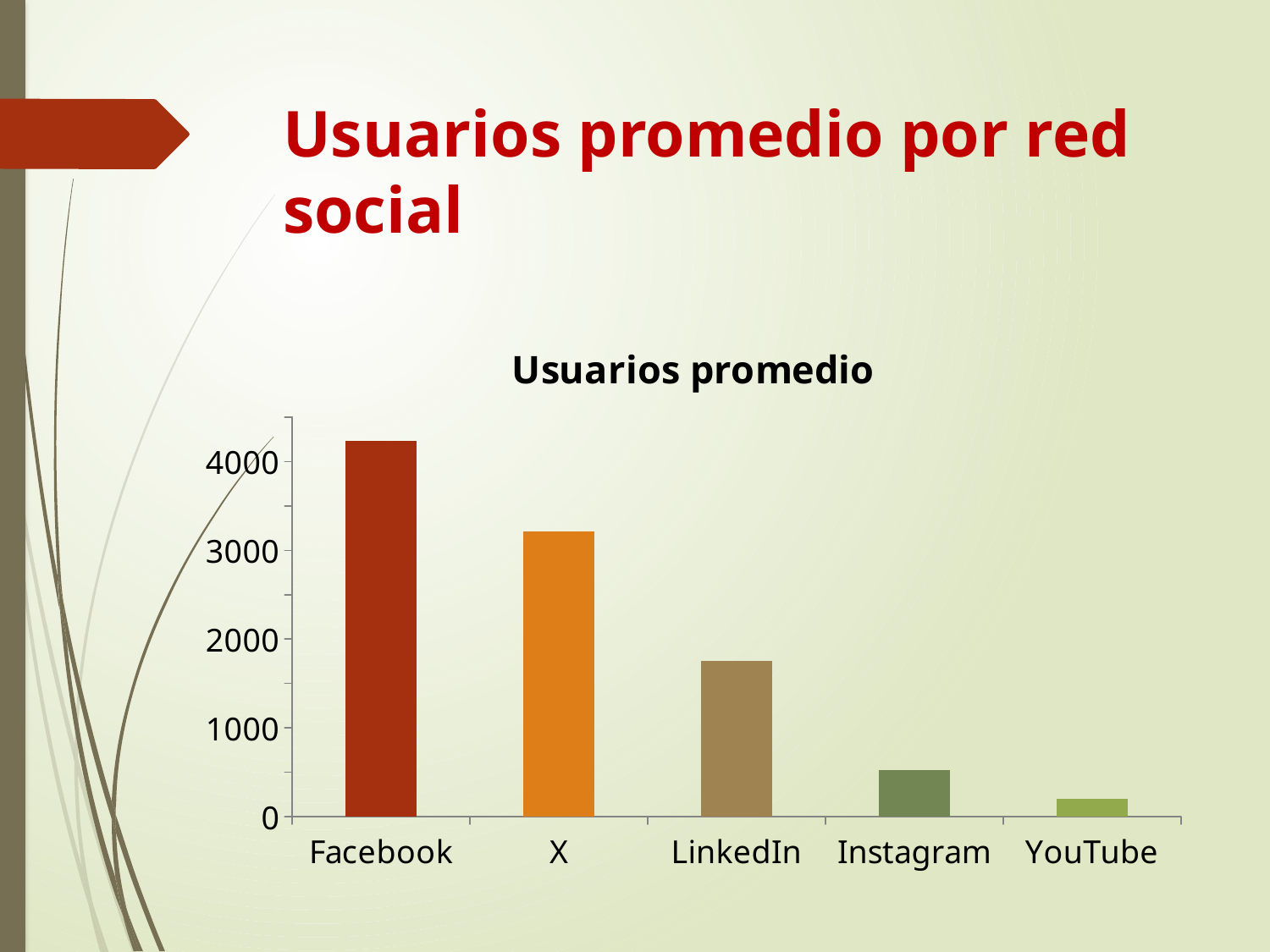
Which has more average users, X or LinkedIn? X Which social network has the lowest average number of users? YouTube What is the title of the chart? Usuarios promedio Do the values rise or fall from left to right along the x axis? fall Which social network has the highest average number of users? Facebook Is the value for Facebook greater or less than 4000? greater How many social networks are shown on the x axis of the chart? 5 Which has more average users, Instagram or YouTube? Instagram Is the value for LinkedIn greater or less than 2000? less Is the value for X greater or less than 3000? greater What kind of chart is shown on the slide? bar chart